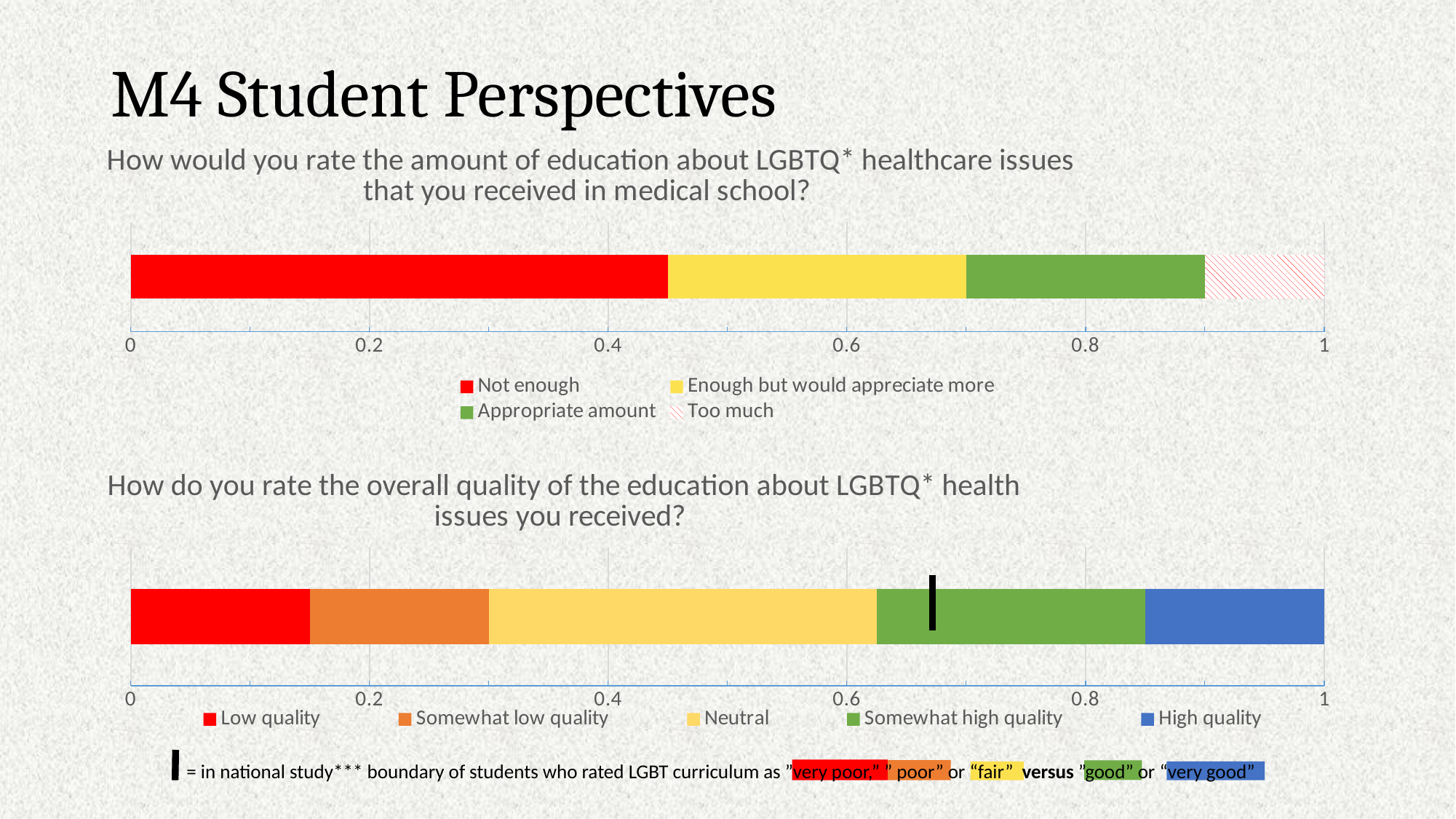
What kind of chart is the top chart, titled "How would you rate the amount of education about LGBTQ* healthcare issues that you received in medical school?"? Stacked bar chart In the bottom chart, is the value for Neutral greater or less than 0.2? greater In the top chart, which response category has the largest segment? Not enough How many series does the legend of the top chart list? 4 In the bottom chart, is the value for Low quality greater or less than 0.2? less In the bottom chart, which response category has the largest segment? Neutral In the bottom chart, what colour represents the High quality series? Blue In the top chart, which is larger: the segment for Not enough or the segment for Appropriate amount? Not enough In the bottom chart, which is larger: the segment for Neutral or the segment for High quality? Neutral In the top chart, is the value for Not enough greater or less than 0.4? greater How many series does the legend of the bottom chart, about overall quality of education, list? 5 In the top chart, which response category has the smallest segment? Too much